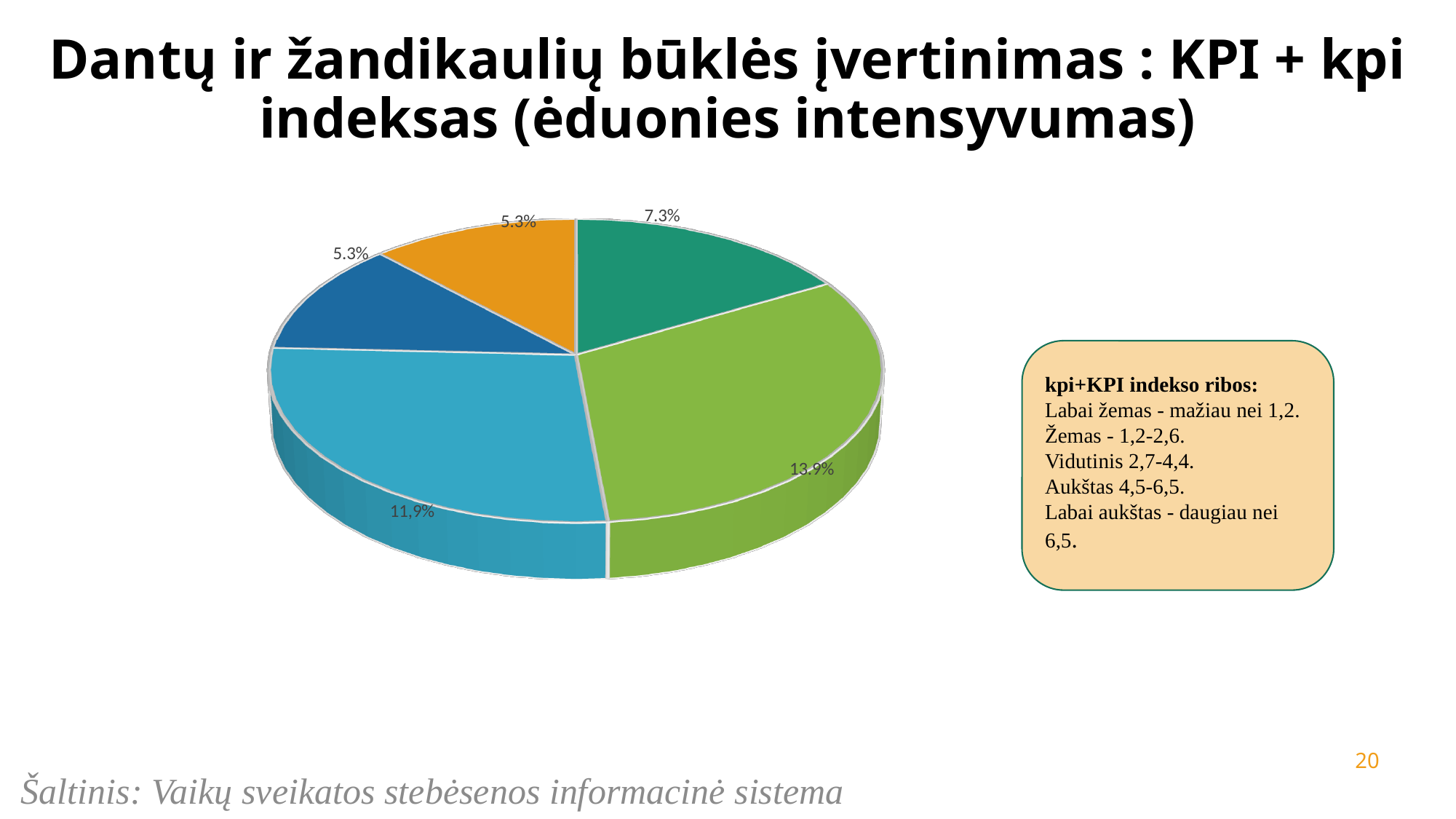
What value is labelled on the teal (dark green) slice at the top of the pie chart? 7.3% What is the smallest value labelled on the pie chart? 5.3% What is the difference between the green slice (13.9%) and the light blue slice (11.9%)? 2.0 percentage points How many slices on the pie chart are labelled 5.3%? 2 What kind of chart is shown on the slide? Pie chart What value is labelled on the orange slice of the pie chart? 5.3% What is the largest value labelled on the pie chart? 13.9% What value is labelled on the light blue slice of the pie chart? 11.9% According to the text box on the slide, what kpi+KPI index range is classified as 'Vidutinis'? 2,7-4,4 What value is labelled on the green slice of the pie chart? 13.9% How many slices does the pie chart have? 5 Which slice is larger, the green slice or the light blue slice? The green slice